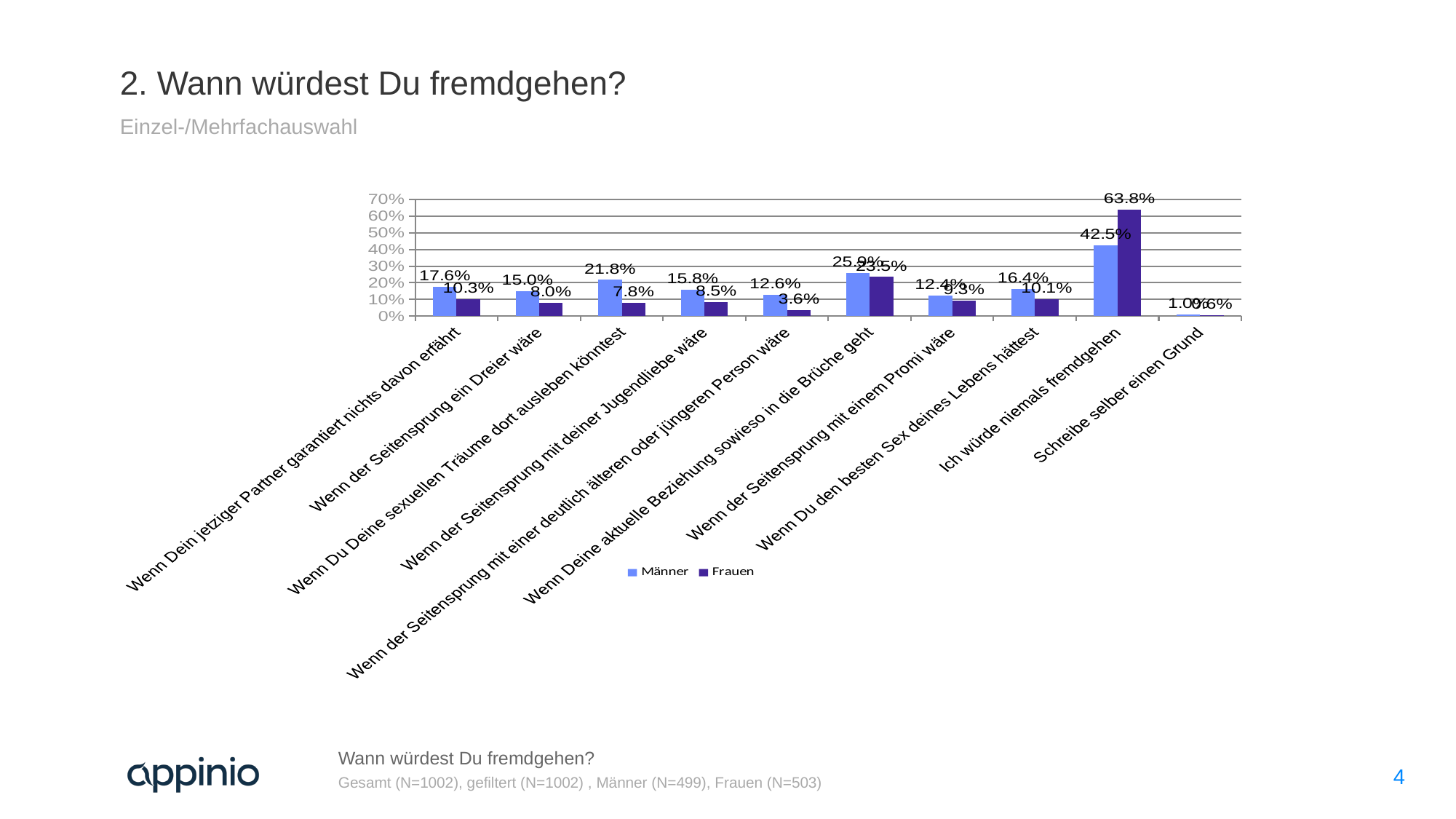
For "Wenn Deine aktuelle Beziehung sowieso in die Brüche geht", which is larger, the Männer value or the Frauen value? Männer How many categories are shown on the x axis? 10 Which category has the highest value for Frauen? Ich würde niemals fremdgehen What is the difference between the Männer and Frauen values for "Wenn Du Deine sexuellen Träume dort ausleben könntest"? 14.0% How many series does the legend list? 2 What is the value for Frauen for "Ich würde niemals fremdgehen"? 63.8% What is the difference between the Frauen and Männer values for "Ich würde niemals fremdgehen"? 21.3% Which category has the highest value for Männer? Ich würde niemals fremdgehen What is the value for Männer for "Ich würde niemals fremdgehen"? 42.5% What is the value for Frauen for "Wenn der Seitensprung mit einer deutlich älteren oder jüngeren Person wäre"? 3.6% What is the value for Männer for "Wenn Du Deine sexuellen Träume dort ausleben könntest"? 21.8% What kind of chart is shown on the slide? Bar chart